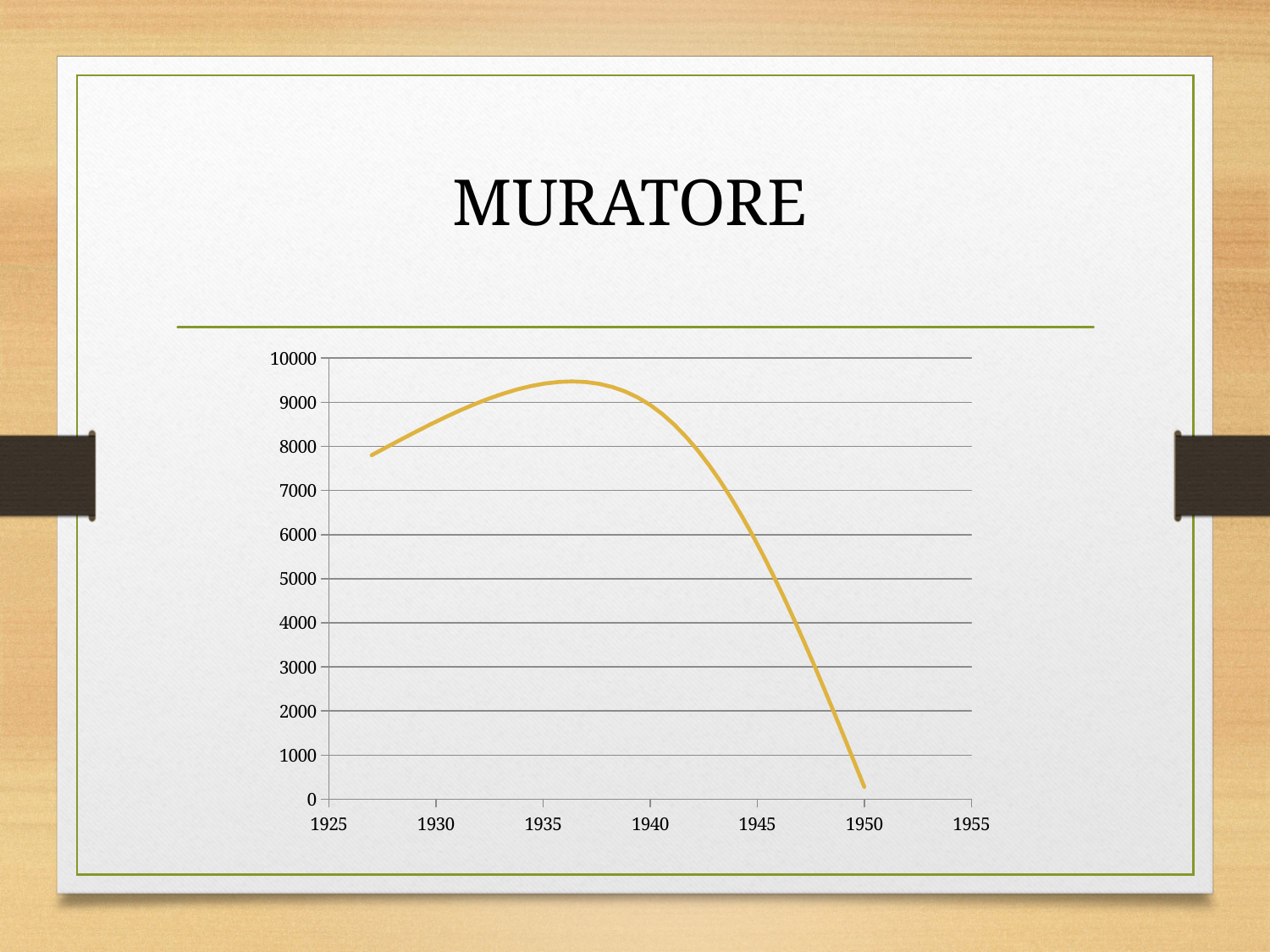
What is the highest value shown on the y axis? 10000 Is the value of the line at 1945 greater or less than 5000? greater At which year on the x axis does the line reach its lowest value? 1950 Is the value of the line at 1930 greater or less than 8000? greater Does the line rise or fall between 1930 and 1935? rise Is the value of the line at 1950 greater or less than 1000? less What kind of chart is shown on the slide? line chart Does the line rise or fall between 1940 and 1950? fall What is the title of the slide containing the chart? MURATORE